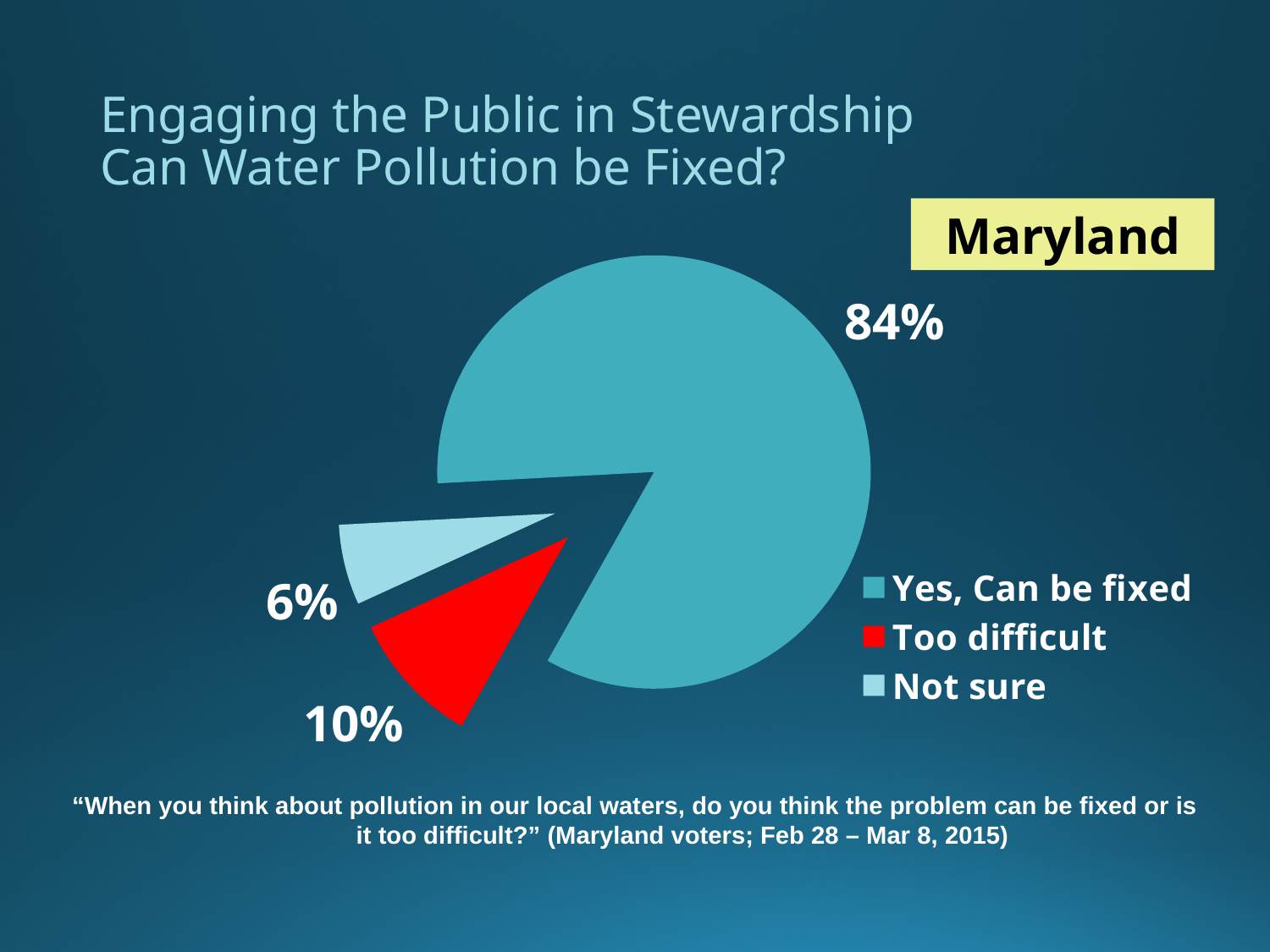
Which response has the smallest share of the pie? Not sure Which is larger, the share for 'Too difficult' or the share for 'Not sure'? Too difficult How many categories does the legend list? 3 What colour is the 'Too difficult' slice? red What is the difference in percentage points between 'Yes, Can be fixed' and 'Too difficult'? 74 Which response has the largest share of the pie? Yes, Can be fixed What percentage of Maryland voters said 'Too difficult'? 10% What kind of chart is shown on the slide? pie chart What is the difference in percentage points between 'Too difficult' and 'Not sure'? 4 What percentage of Maryland voters said 'Yes, Can be fixed'? 84% Which state's voters does the chart represent? Maryland What percentage of Maryland voters said 'Not sure'? 6%